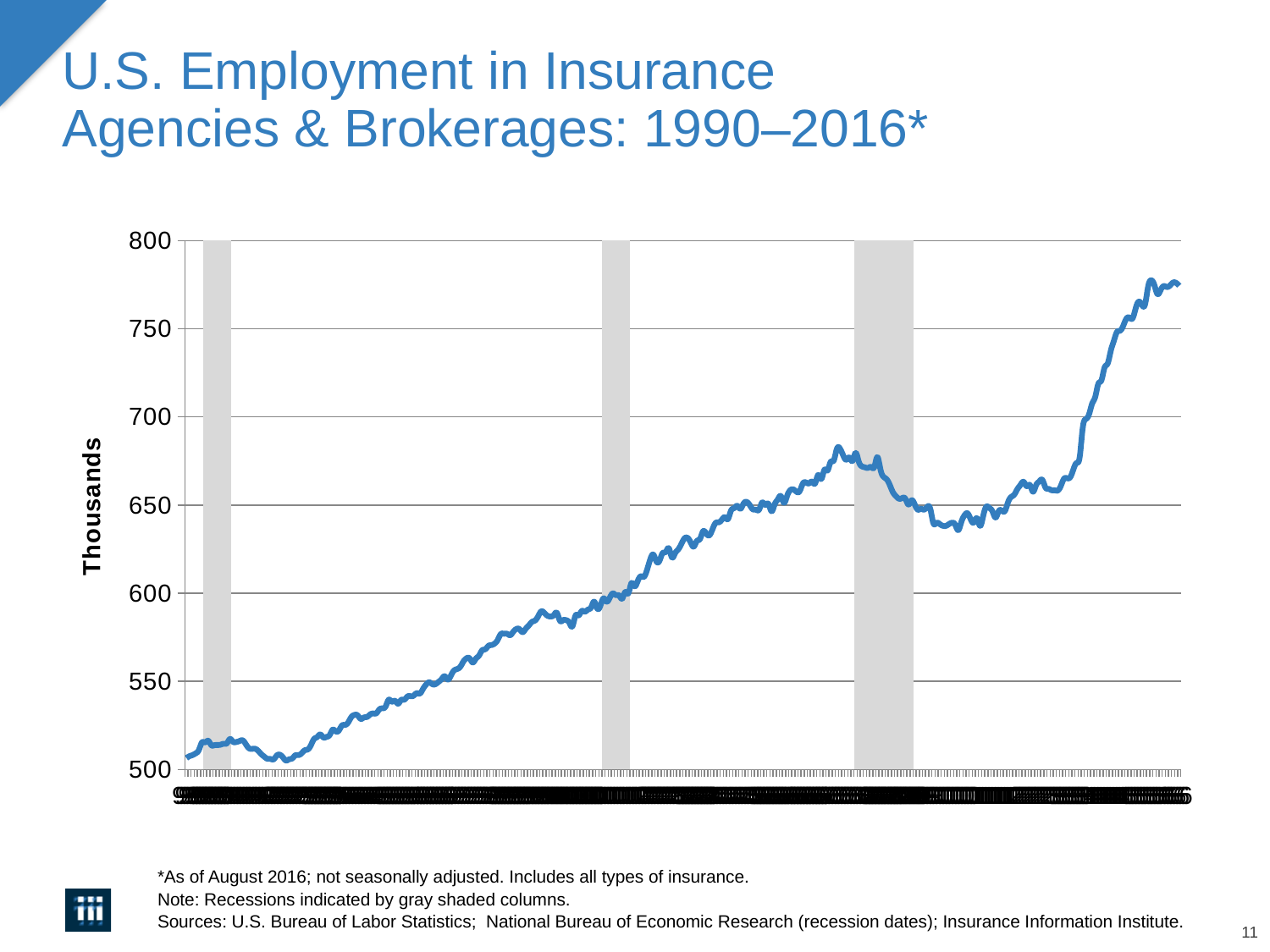
Which is larger: the value at the right end of the line (2016) or the value at the left end of the line (1990)? 2016 What is the label on the vertical axis of the chart? Thousands Is the value at the far right end of the line greater or less than 800? less Is the peak reached just before the third gray shaded column greater or less than 700? less What is the title of the chart on the slide? U.S. Employment in Insurance Agencies & Brokerages: 1990–2016* Is the value at the far right end of the line (2016) greater or less than 750? greater Overall, do the values rise or fall from the left end of the chart to the right end? rise What kind of chart is shown on the slide? line chart What is the highest value shown on the vertical axis? 800 How many gray shaded recession columns are shown on the chart? 3